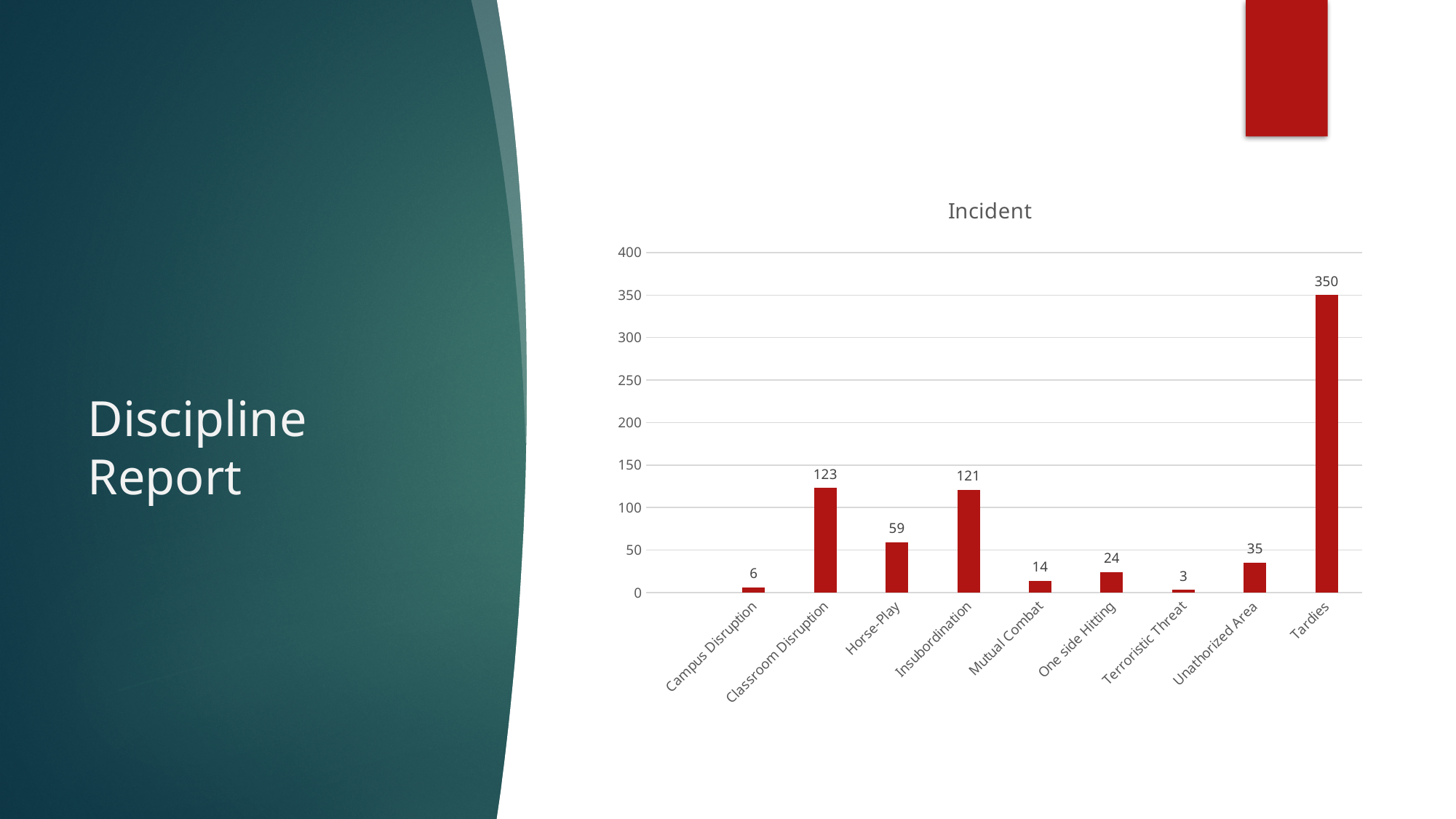
What is the value for Horse-Play? 59 What is the title of the chart? Incident Which is larger, the value for Unathorized Area or the value for One side Hitting? Unathorized Area What kind of chart is shown on the slide? Bar chart How many categories are shown on the x axis? 9 What is the value for Tardies? 350 Which category has the lowest value? Terroristic Threat What is the value for Classroom Disruption? 123 What is the difference between the values for Tardies and Classroom Disruption? 227 Is the value for Insubordination greater or less than 100? greater What is the value for Terroristic Threat? 3 Which category has the highest value? Tardies